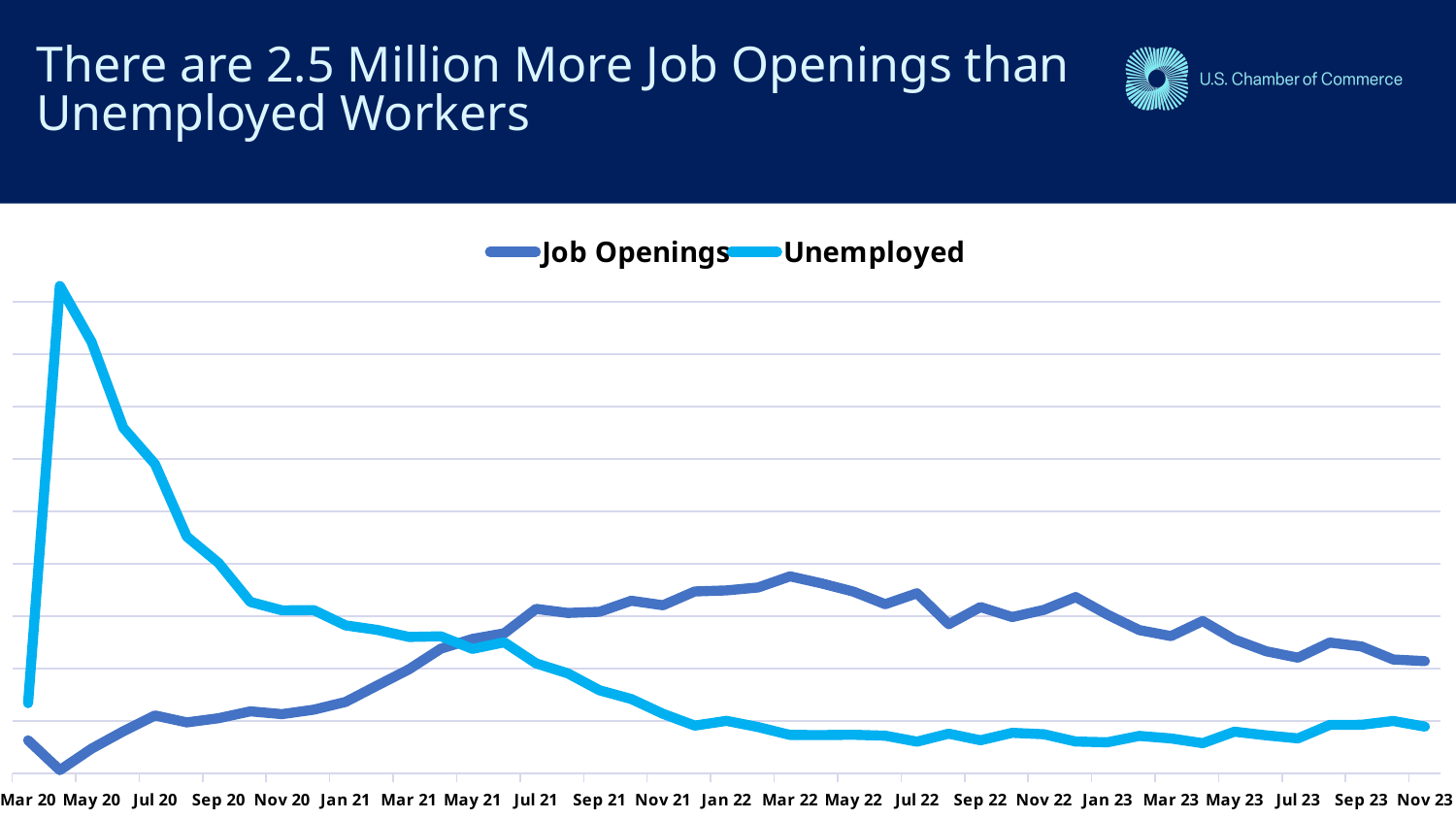
Does the Job Openings line rise or fall between Mar 22 and Nov 23? Fall Which series reaches the lowest point anywhere on the chart? Job Openings At Nov 23, which series is higher, Job Openings or Unemployed? Job Openings What are the two series named in the legend? Job Openings and Unemployed At Mar 20, which series is higher, Job Openings or Unemployed? Unemployed How many month labels are shown along the x axis? 23 At Jan 21, which series is higher, Job Openings or Unemployed? Unemployed What kind of chart is shown on the slide? Line chart At which labeled month does the Job Openings line reach its highest point? Mar 22 Does the Unemployed line rise or fall between May 20 and Jan 21? Fall How many series does the legend list? 2 What is the title of the slide containing the chart? There are 2.5 Million More Job Openings than Unemployed Workers